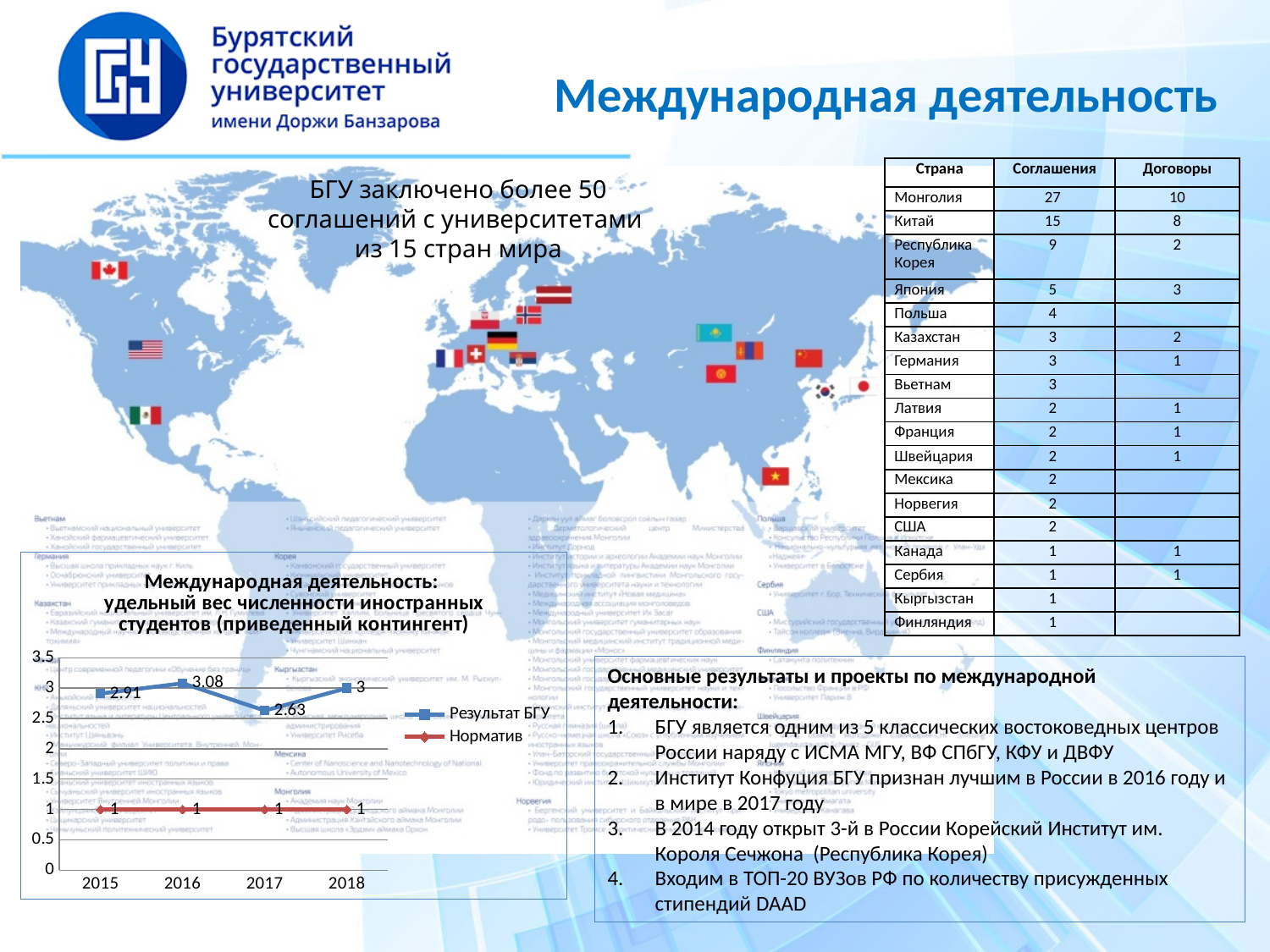
In which year is 'Результат БГУ' highest? 2016 What is the value of 'Результат БГУ' for 2015? 2.91 How many series does the chart legend list? 2 Does the 'Норматив' series rise, fall or stay flat from 2015 to 2018? stays flat What is the difference between 'Результат БГУ' and 'Норматив' in 2018? 2 What is the difference between 'Результат БГУ' in 2016 and 2017? 0.45 What is the value of 'Норматив' for 2018? 1 What is the value of 'Результат БГУ' for 2017? 2.63 Which is larger: 'Результат БГУ' in 2015 or in 2018? 2018 In which year is 'Результат БГУ' lowest? 2017 How many years are shown on the x axis of the chart? 4 What type of chart is shown on the slide? line chart